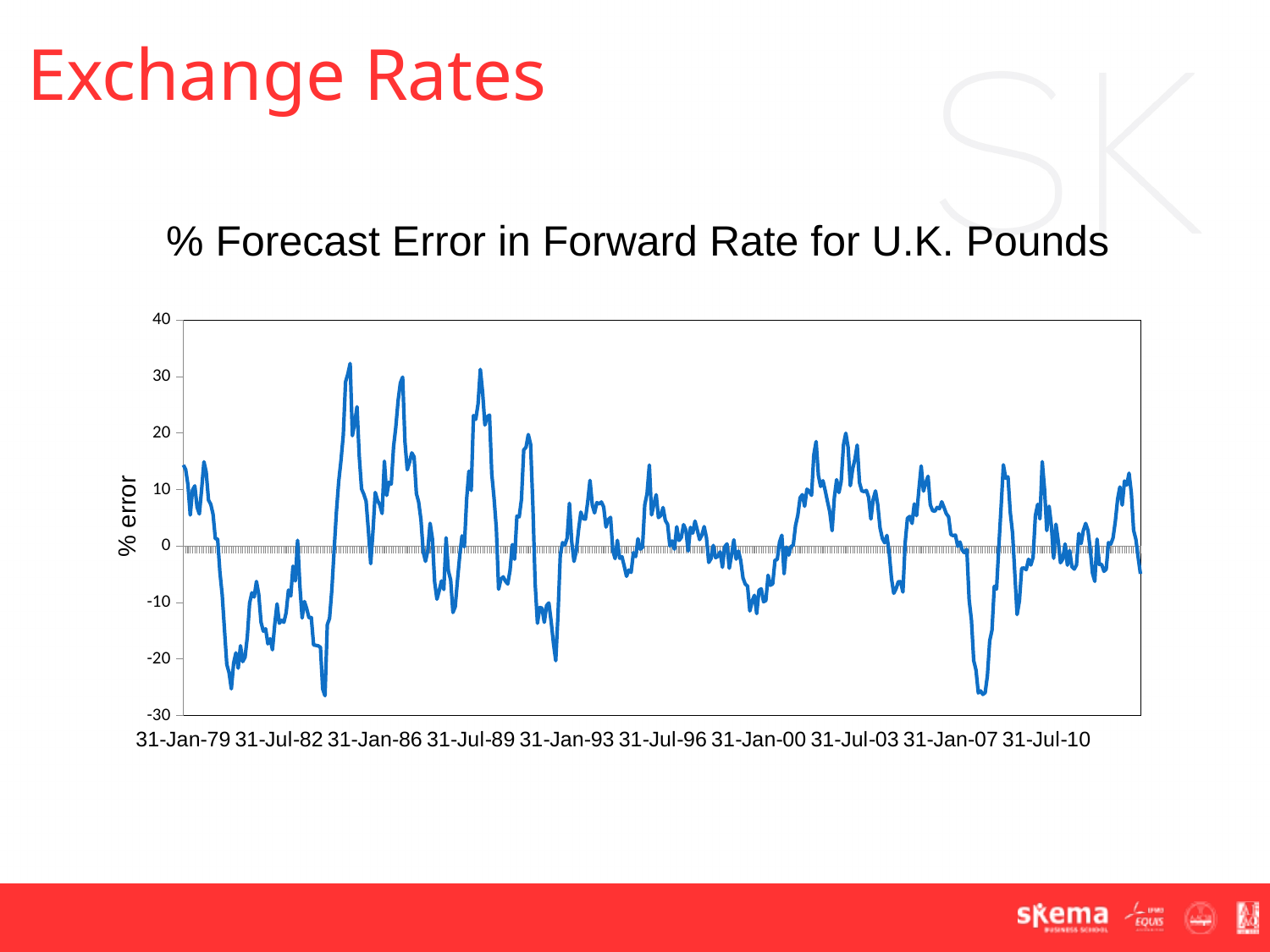
How many date labels are shown along the horizontal axis? 10 What is the lowest value shown on the vertical axis? -30 Does the line ever rise above 30 on the vertical axis? Yes Is the value at 31-Jan-79 greater or less than 10? greater Does the line ever fall below -20 on the vertical axis? Yes What is the last date label on the horizontal axis? 31-Jul-10 What is the title of the chart? % Forecast Error in Forward Rate for U.K. Pounds What is the highest value shown on the vertical axis? 40 What is the first date label on the horizontal axis? 31-Jan-79 What kind of chart is shown on the slide? Line chart What is the label on the vertical axis of the chart? % error